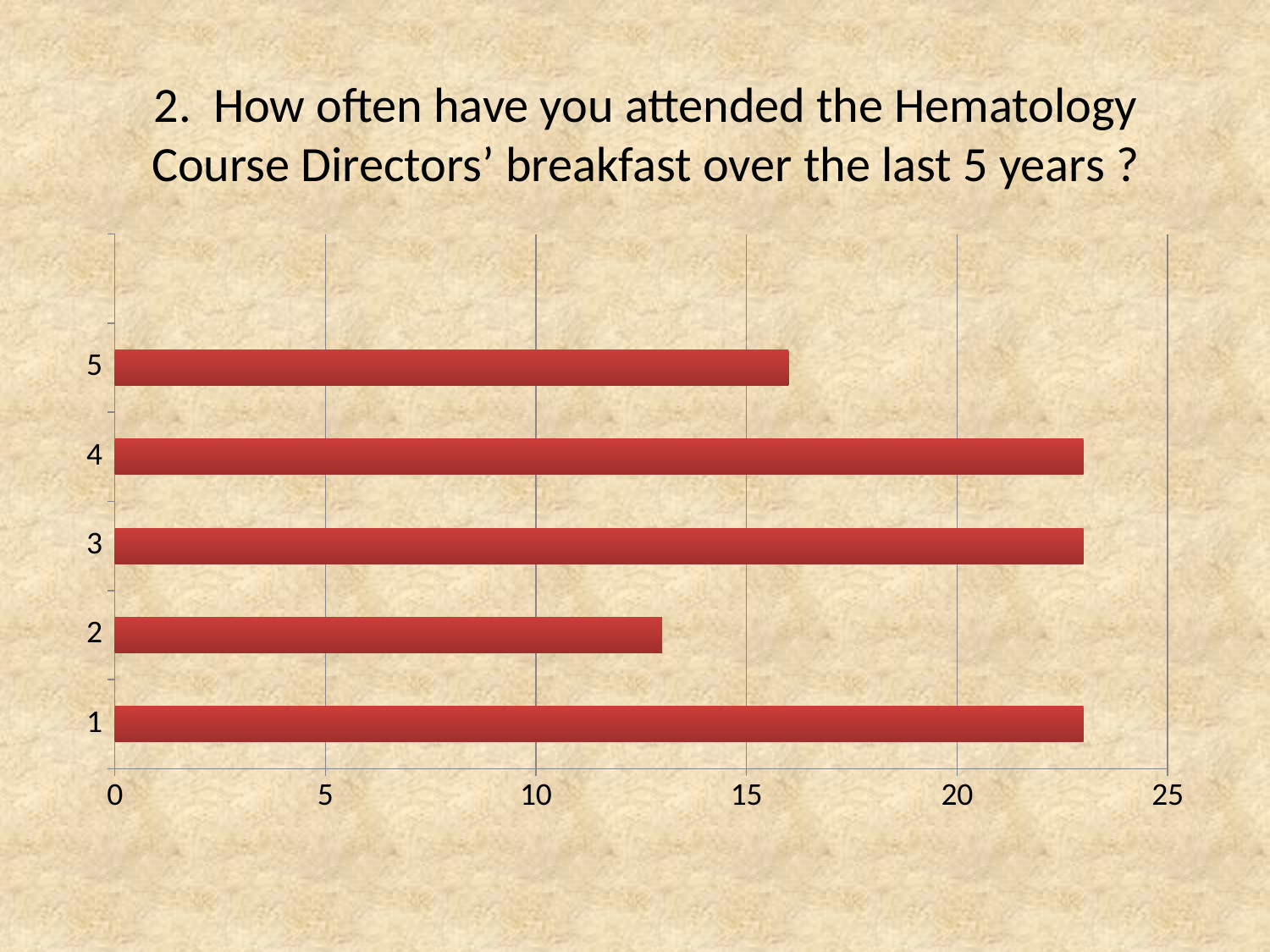
Is the value for category 1 greater or less than 25? less What is the highest value shown on the horizontal axis? 25 What kind of chart is shown on the slide? bar chart Which is larger, the value for category 5 or the value for category 2? 5 How many categories are shown on the chart? 5 Is the value for category 2 greater or less than 15? less Is the value for category 2 greater or less than 10? greater Which category has the lowest value? 2 Which is larger, the value for category 1 or the value for category 5? 1